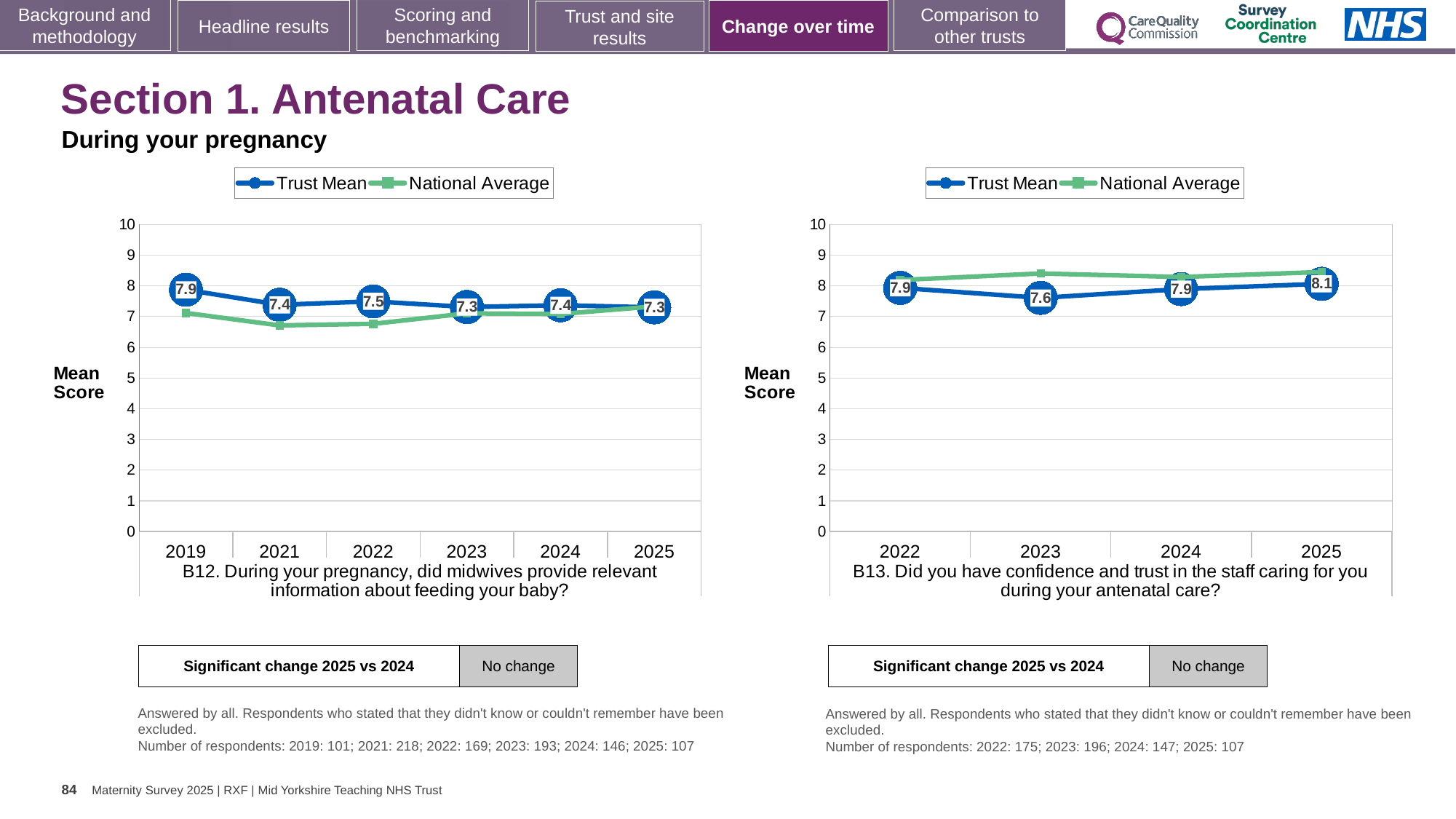
In the left chart (B12), what is the Trust Mean for 2025? 7.3 What kind of chart is the right chart (B13)? Line chart In the left chart (B12), what is the Trust Mean for 2019? 7.9 In the right chart (B13), what is the difference between the Trust Mean for 2025 and 2023? 0.5 In the left chart (B12), is the Trust Mean for 2019 or 2021 larger? 2019 How many years are plotted on the x axis of the left chart (B12)? 6 How many series does the legend of the right chart (B13) list? 2 In the left chart (B12), which year has the highest Trust Mean? 2019 In the right chart (B13), what is the Trust Mean for 2025? 8.1 In the right chart (B13), what is the Trust Mean for 2023? 7.6 In the left chart (B12), is the National Average for 2021 greater or less than 7? less In the right chart (B13), which year has the lowest Trust Mean? 2023